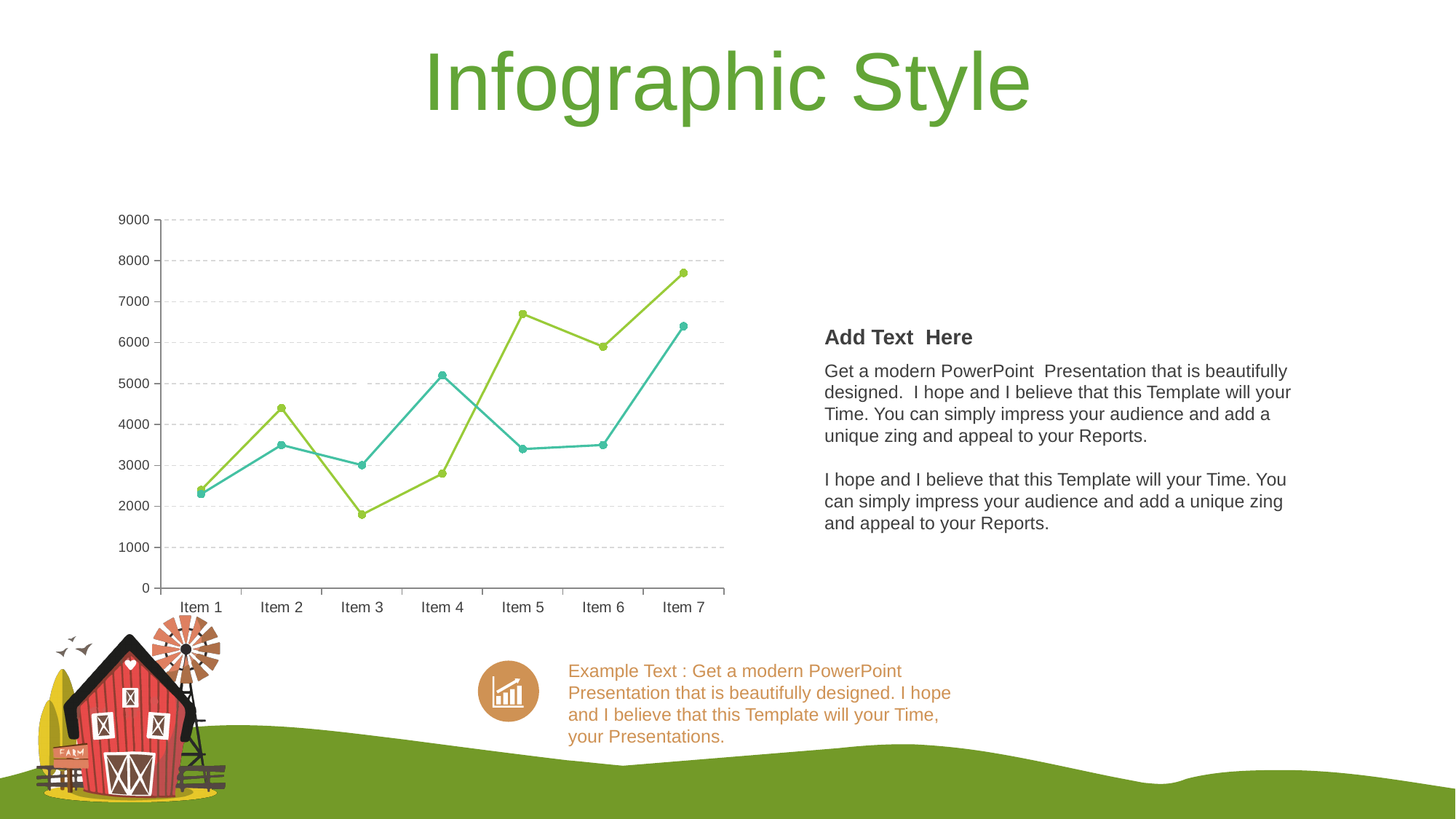
Is the value of the teal line at Item 1 greater or less than 3000? less At which item does the teal line reach its highest value? Item 7 At Item 4, which line has the higher value, the light green line or the teal line? teal line At which item does the light green line reach its lowest value? Item 3 At which item does the light green line reach its highest value? Item 7 Is the value of the light green line at Item 3 greater or less than 2000? less Is the value of the light green line at Item 7 greater or less than 7000? greater How many lines are plotted on the chart? 2 What kind of chart is shown on the slide? line chart How many categories are shown on the x axis of the chart? 7 At Item 5, which line has the higher value, the light green line or the teal line? light green line